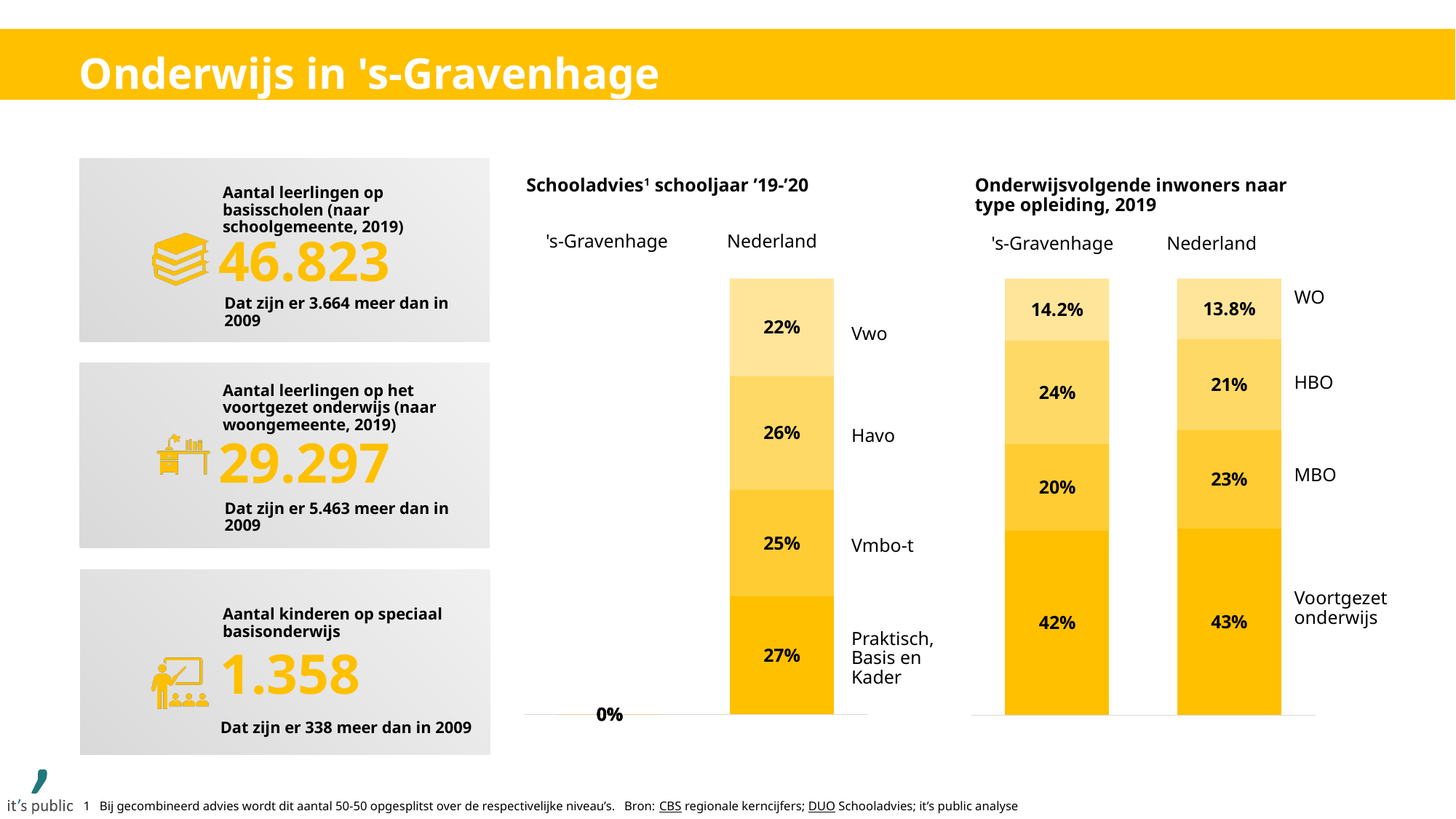
In the 'Onderwijsvolgende inwoners naar type opleiding, 2019' chart, which segment is the largest in the 's-Gravenhage bar? Voortgezet onderwijs In the 'Schooladvies schooljaar '19-'20' chart, which segment of the Nederland bar is the smallest? Vwo In the 'Schooladvies schooljaar '19-'20' chart, what is the difference between the Havo and Vmbo-t shares for Nederland? 1% In the 'Schooladvies schooljaar '19-'20' chart, what percentage of the Nederland bar is Vwo? 22% In the 'Onderwijsvolgende inwoners naar type opleiding, 2019' chart, what is the difference between the Voortgezet onderwijs shares of Nederland and 's-Gravenhage? 1% In the 'Schooladvies schooljaar '19-'20' chart, what percentage of the Nederland bar is Praktisch, Basis en Kader? 27% In the 'Onderwijsvolgende inwoners naar type opleiding, 2019' chart, which has the larger HBO share, 's-Gravenhage or Nederland? 's-Gravenhage In the 'Onderwijsvolgende inwoners naar type opleiding, 2019' chart, what is the MBO share for Nederland? 23% In the 'Onderwijsvolgende inwoners naar type opleiding, 2019' chart, what is the combined share of WO and HBO for 's-Gravenhage? 38.2% What kind of chart is the 'Onderwijsvolgende inwoners naar type opleiding, 2019' chart? Stacked bar chart In the 'Onderwijsvolgende inwoners naar type opleiding, 2019' chart, what is the WO share for 's-Gravenhage? 14.2% In the 'Schooladvies schooljaar '19-'20' chart, how many segments make up the Nederland bar? 4